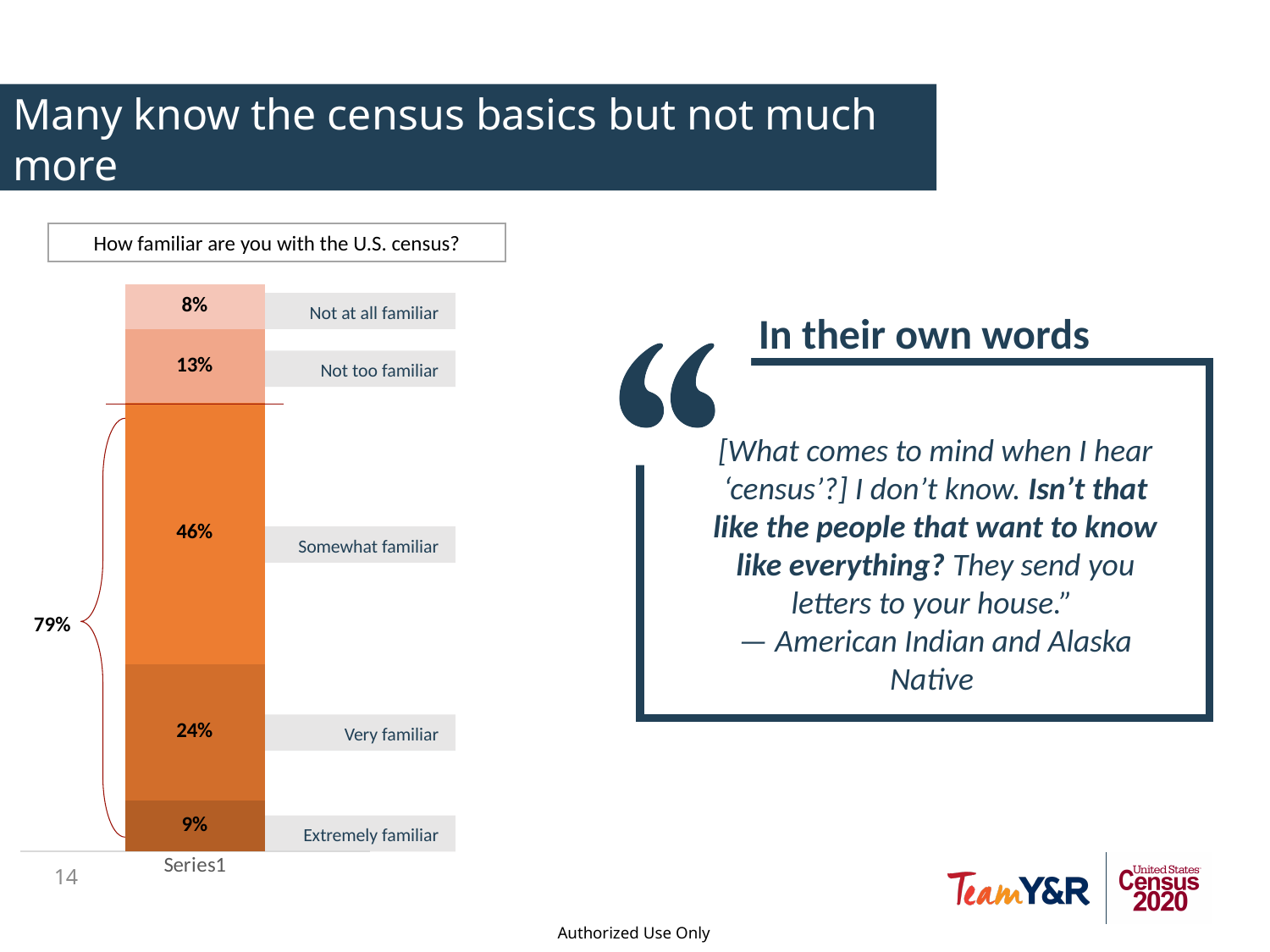
What percentage of respondents said they are Very familiar with the U.S. census? 24% What is the difference between the Somewhat familiar and Very familiar percentages? 22% Which familiarity level has the lowest percentage? Not at all familiar Which is larger, the Not too familiar percentage or the Extremely familiar percentage? Not too familiar What kind of chart is shown on the slide? Stacked bar chart What survey question is shown above the chart? How familiar are you with the U.S. census? What percentage of respondents said they are Somewhat familiar with the U.S. census? 46% What combined percentage is indicated by the bracket covering Somewhat, Very and Extremely familiar? 79% What percentage of respondents said they are Extremely familiar with the U.S. census? 9% How many familiarity categories are shown in the stacked bar? 5 Which familiarity level has the highest percentage? Somewhat familiar What percentage of respondents said they are Not at all familiar with the U.S. census? 8%